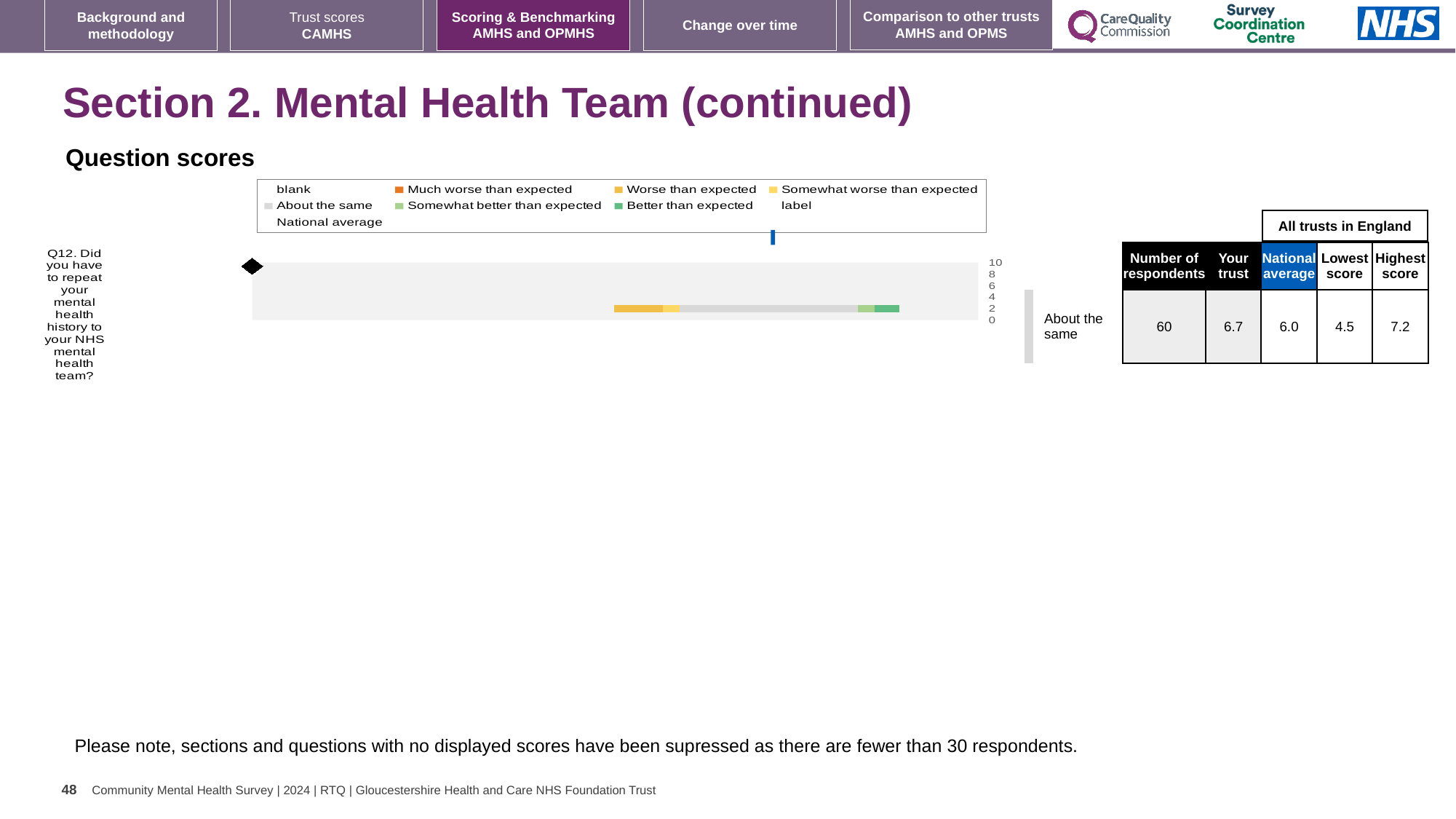
How many survey questions are plotted in the Question scores chart? 1 By how much does the 'Your trust' score for Q12 exceed the national average? 0.7 What kind of chart is used to show the Q12 question score? bar chart What is the national average score for Q12? 6.0 For Q12, which is higher: the 'Your trust' score or the national average? Your trust How many respondents answered Q12? 60 What benchmark rating is shown beside the bar for Q12? About the same What is the 'Your trust' score for Q12? 6.7 What is the difference between the highest and lowest trust scores for Q12? 2.7 Which question is plotted in the Question scores chart? Q12. Did you have to repeat your mental health history to your NHS mental health team? What is the highest score among all trusts in England for Q12? 7.2 What is the lowest score among all trusts in England for Q12? 4.5